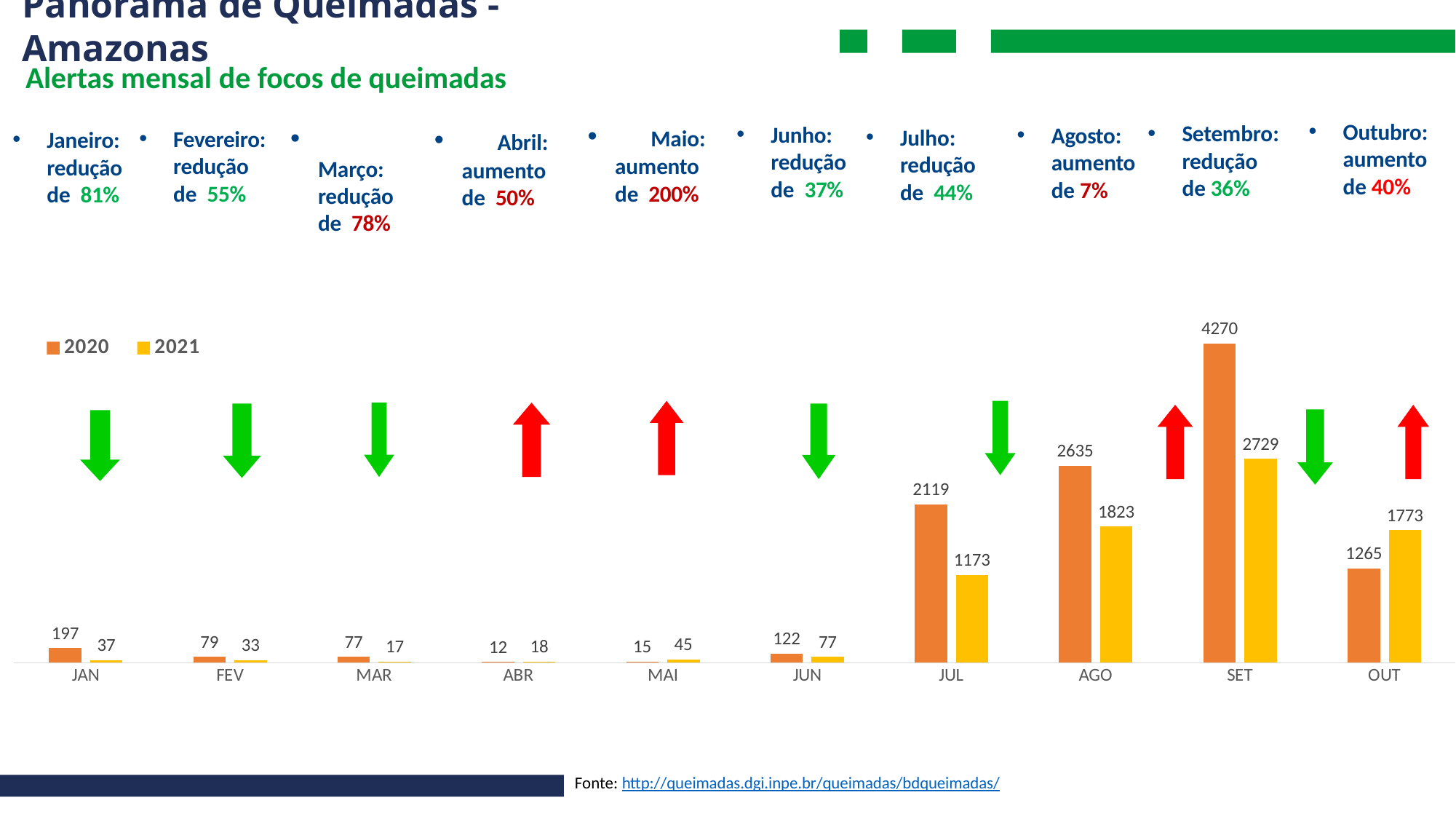
What kind of chart is shown? bar chart Which is larger for OUT, the 2020 value or the 2021 value? 2021 What is the 2020 value for SET? 4270 Which month has the highest 2020 value? SET Which colour represents the 2021 series? yellow How many months are shown on the x axis? 10 What is the 2021 value for OUT? 1773 What is the 2021 value for JUL? 1173 Which month has the lowest 2020 value? ABR What is the difference between the 2020 and 2021 values for AGO? 812 What is the 2020 value for JAN? 197 How many series does the legend list? 2